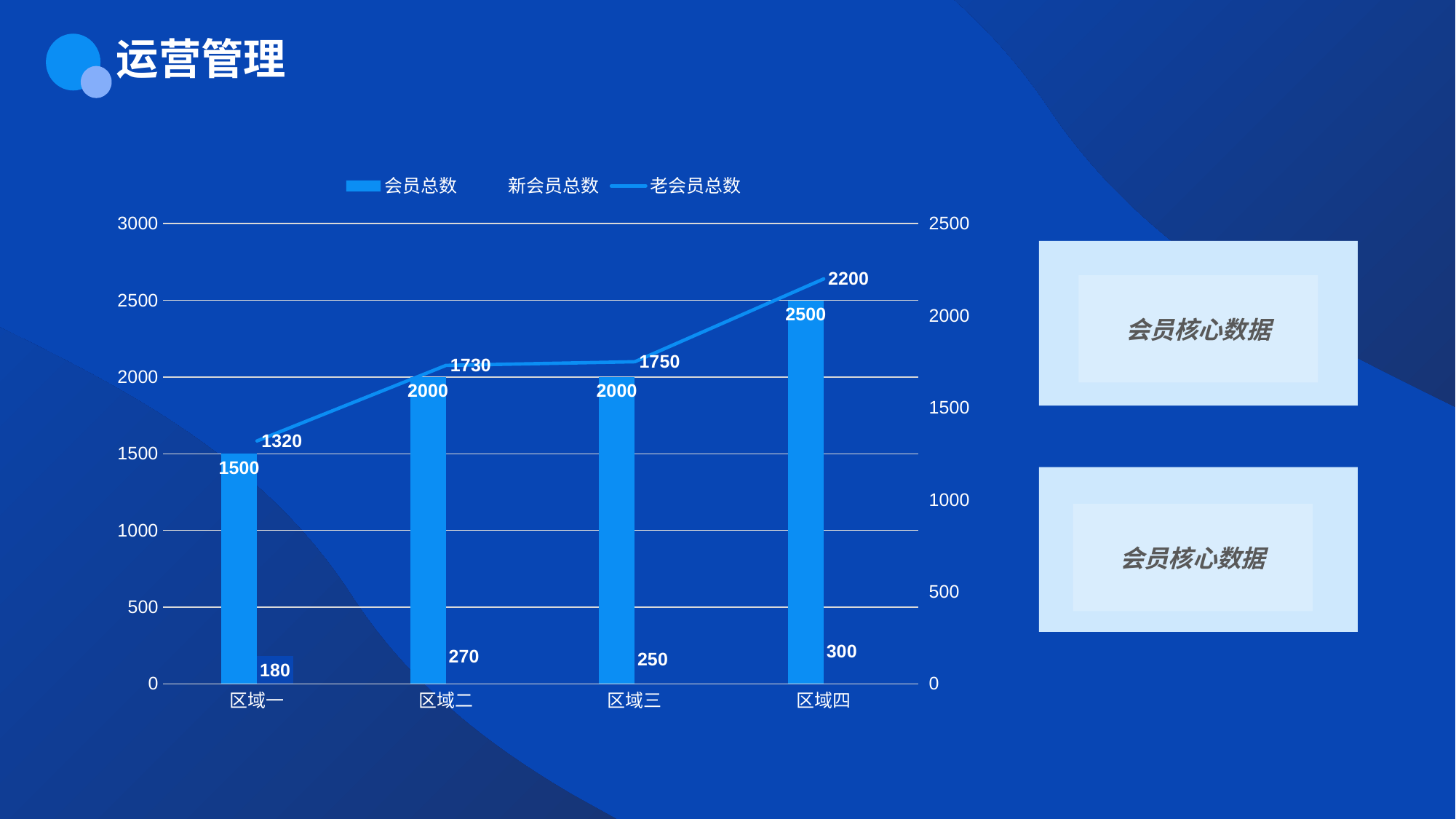
How many series does the legend list? 3 How many categories are shown on the x axis? 4 Which category has the highest 老会员总数 value? 区域四 What is the difference between the 会员总数 values for 区域四 and 区域一? 1000 Which category has the lowest 会员总数 value? 区域一 What is the 会员总数 value for 区域四? 2500 What is the difference between the 老会员总数 values for 区域三 and 区域二? 20 What is the 新会员总数 value for 区域一? 180 Which series is drawn as a line in the chart? 老会员总数 What is the 老会员总数 value for 区域二? 1730 Does the 老会员总数 line rise or fall from 区域一 to 区域四? rise Which is larger, the 新会员总数 value for 区域二 or for 区域三? 区域二